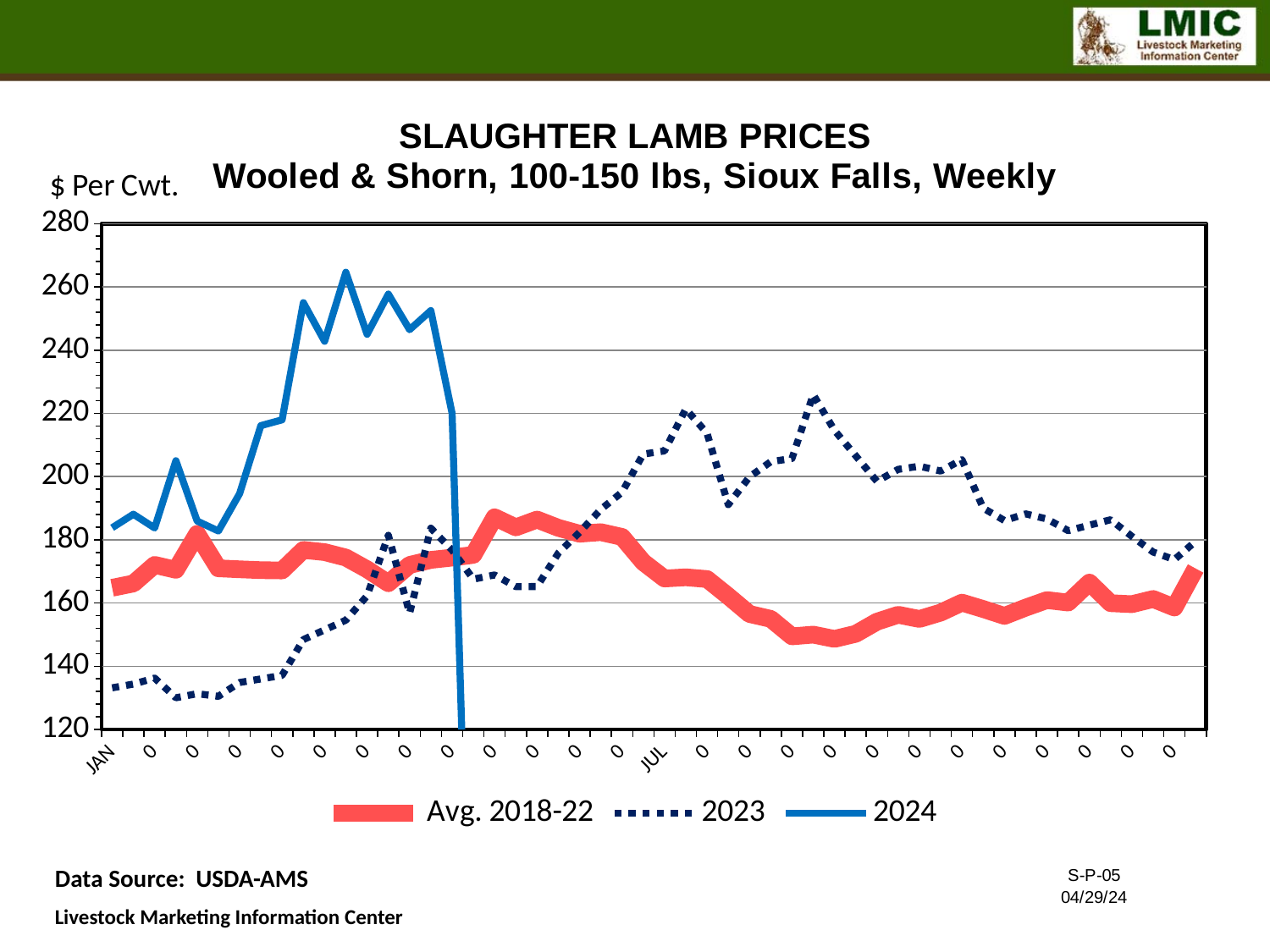
Does the 2023 series generally rise or fall from JAN to JUL? rise Is the Avg. 2018-22 value at JAN greater or less than 160? greater At JAN, which is larger: the 2024 value or the 2023 value? 2024 Which series has the lowest value at JAN? 2023 How many series does the legend list? 3 Is the peak value of the 2023 series greater or less than 200? greater Is the peak value of the 2024 series greater or less than 240? greater Which series reaches the highest value on the chart? 2024 What is the title of the chart? SLAUGHTER LAMB PRICES Wooled & Shorn, 100-150 lbs, Sioux Falls, Weekly Which series is drawn as a dashed line? 2023 What kind of chart is shown on the slide? line chart